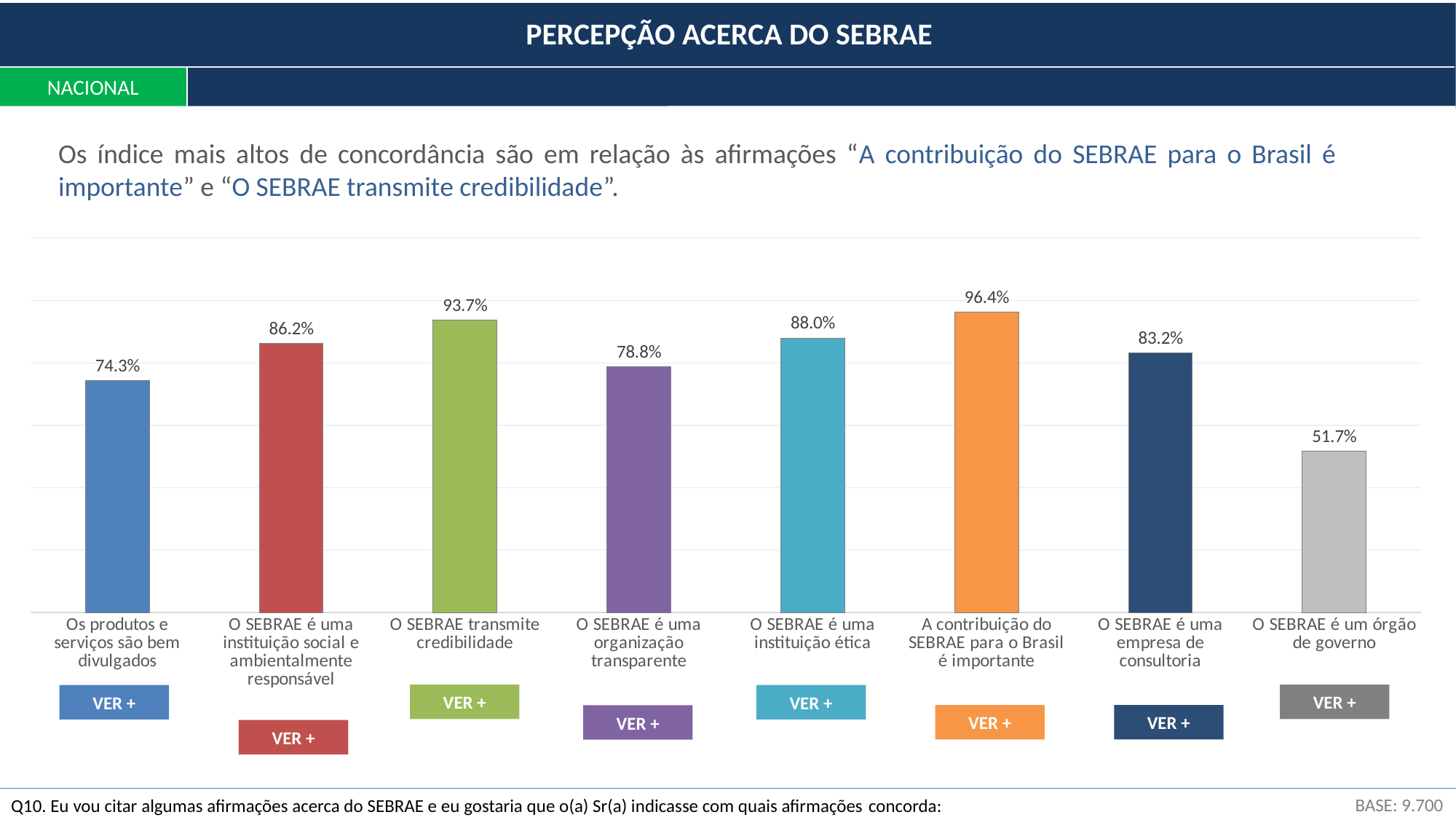
What colour is the bar for "A contribuição do SEBRAE para o Brasil é importante"? Orange What is the value shown for "O SEBRAE é uma instituição ética"? 88.0% What is the value shown for "O SEBRAE é um órgão de governo"? 51.7% What is the difference in percentage points between "O SEBRAE transmite credibilidade" and "O SEBRAE é uma instituição social e ambientalmente responsável"? 7.5 What type of chart is shown on the slide? Bar chart What percentage of respondents agree that "A contribuição do SEBRAE para o Brasil é importante"? 96.4% What is the difference in percentage points between the highest and lowest bars? 44.7 What is the value shown for "O SEBRAE transmite credibilidade"? 93.7% Which is larger: the value for "O SEBRAE é uma empresa de consultoria" or the value for "O SEBRAE é uma organização transparente"? O SEBRAE é uma empresa de consultoria Which statement has the highest level of agreement? A contribuição do SEBRAE para o Brasil é importante How many statements (bars) are shown in the chart? 8 Which statement has the lowest level of agreement? O SEBRAE é um órgão de governo